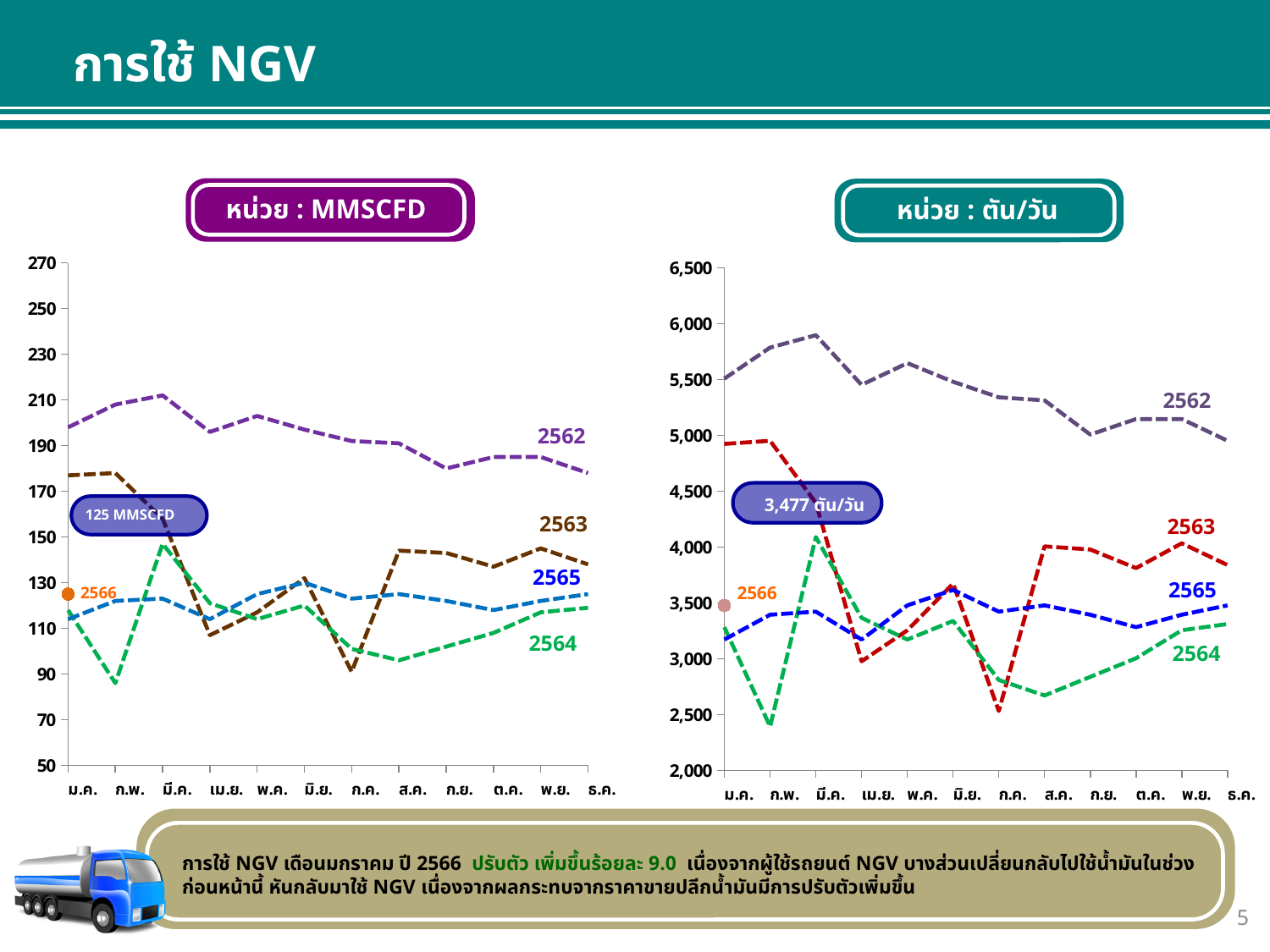
In the left chart (หน่วย : MMSCFD), which year series is the highest across the months? 2562 In the right chart (หน่วย : ตัน/วัน), what value is labelled for 2566 in ม.ค.? 3,477 ตัน/วัน In the right chart (หน่วย : ตัน/วัน), which is larger in ม.ค.: the value for 2563 or the value for 2564? 2563 In the left chart (หน่วย : MMSCFD), does the 2562 series overall rise or fall from ม.ค. to ธ.ค.? fall How many months are shown on the x axis of the left chart (หน่วย : MMSCFD)? 12 In the left chart (หน่วย : MMSCFD), is the value for 2564 in ก.พ. greater or less than 110? less In the left chart (หน่วย : MMSCFD), what value is labelled for 2566 in ม.ค.? 125 MMSCFD How many year series are labelled on the right chart (หน่วย : ตัน/วัน)? 5 In the right chart (หน่วย : ตัน/วัน), is the value for 2562 in มี.ค. greater or less than 5,500? greater In the right chart (หน่วย : ตัน/วัน), is the value for 2564 in ก.พ. greater or less than 3,000? less What kind of chart is the left chart (หน่วย : MMSCFD)? line chart